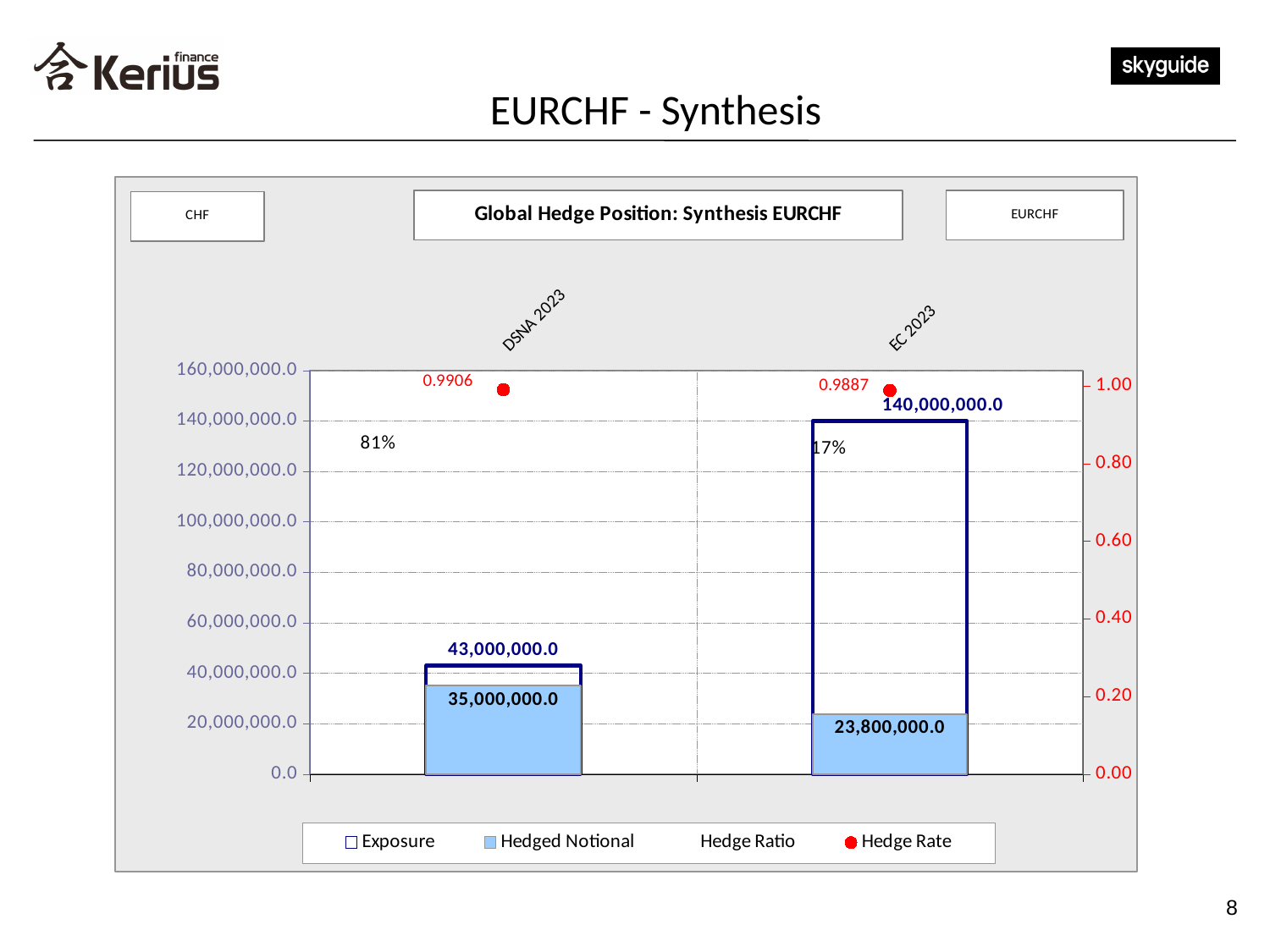
What is the difference between the Exposure and the Hedged Notional for DSNA 2023? 8,000,000.0 What is the Hedged Notional value for DSNA 2023? 35,000,000.0 How many categories are shown on the x axis of the chart? 2 Which category has the lowest Hedged Notional? EC 2023 How many series does the chart legend list? 4 What is the Exposure value for EC 2023? 140,000,000.0 What is the Hedge Ratio shown for EC 2023? 17% Which series is plotted with red circle markers? Hedge Rate What is the difference in Hedged Notional between DSNA 2023 and EC 2023? 11,200,000.0 What is the Hedge Rate for DSNA 2023? 0.9906 Which category has the higher Exposure, DSNA 2023 or EC 2023? EC 2023 What is the title of the chart? Global Hedge Position: Synthesis EURCHF